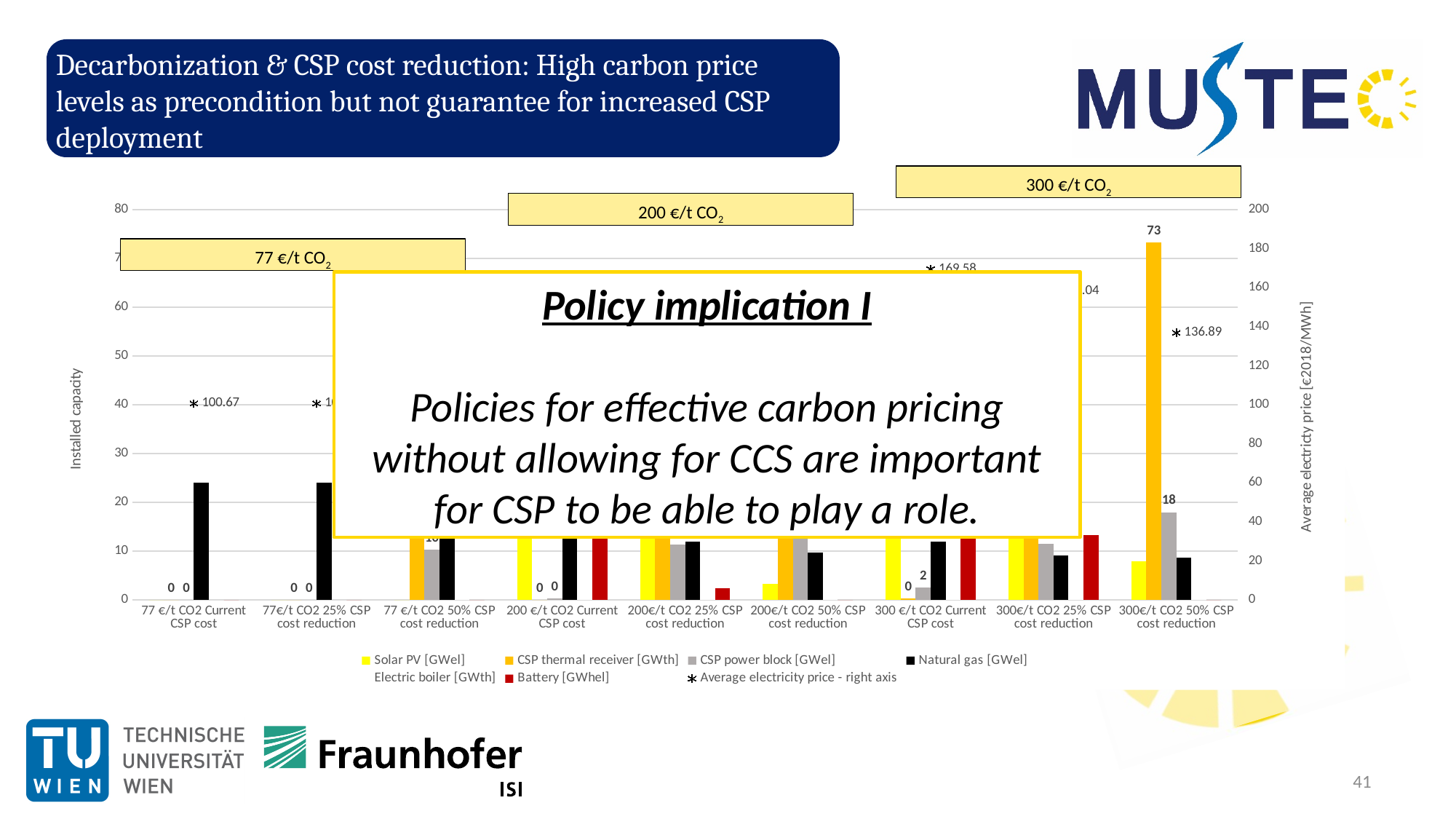
Is the Natural gas [GWel] value for '77 €/t CO2 Current CSP cost' greater or less than 20? greater How many series does the chart legend list? 7 What is the average electricity price shown for the category '300€/t CO2 50% CSP cost reduction'? 136.89 What is the average electricity price shown for the category '77 €/t CO2 Current CSP cost'? 100.67 What is the value of CSP power block [GWel] for the category '300€/t CO2 50% CSP cost reduction'? 18 Which is larger: the average electricity price for '300 €/t CO2 Current CSP cost' (169.58) or for '300€/t CO2 50% CSP cost reduction' (136.89)? 300 €/t CO2 Current CSP cost What is the label of the right-hand vertical axis of the chart? Average electricity price [€2018/MWh] Which category has the tallest bar in the chart? 300€/t CO2 50% CSP cost reduction What is the value of CSP thermal receiver [GWth] for the category '300€/t CO2 50% CSP cost reduction'? 73 How many categories are shown on the x axis of the chart? 9 What kind of chart is shown on the slide? bar chart What is the difference between the CSP thermal receiver value (73) and the CSP power block value (18) in the category '300€/t CO2 50% CSP cost reduction'? 55